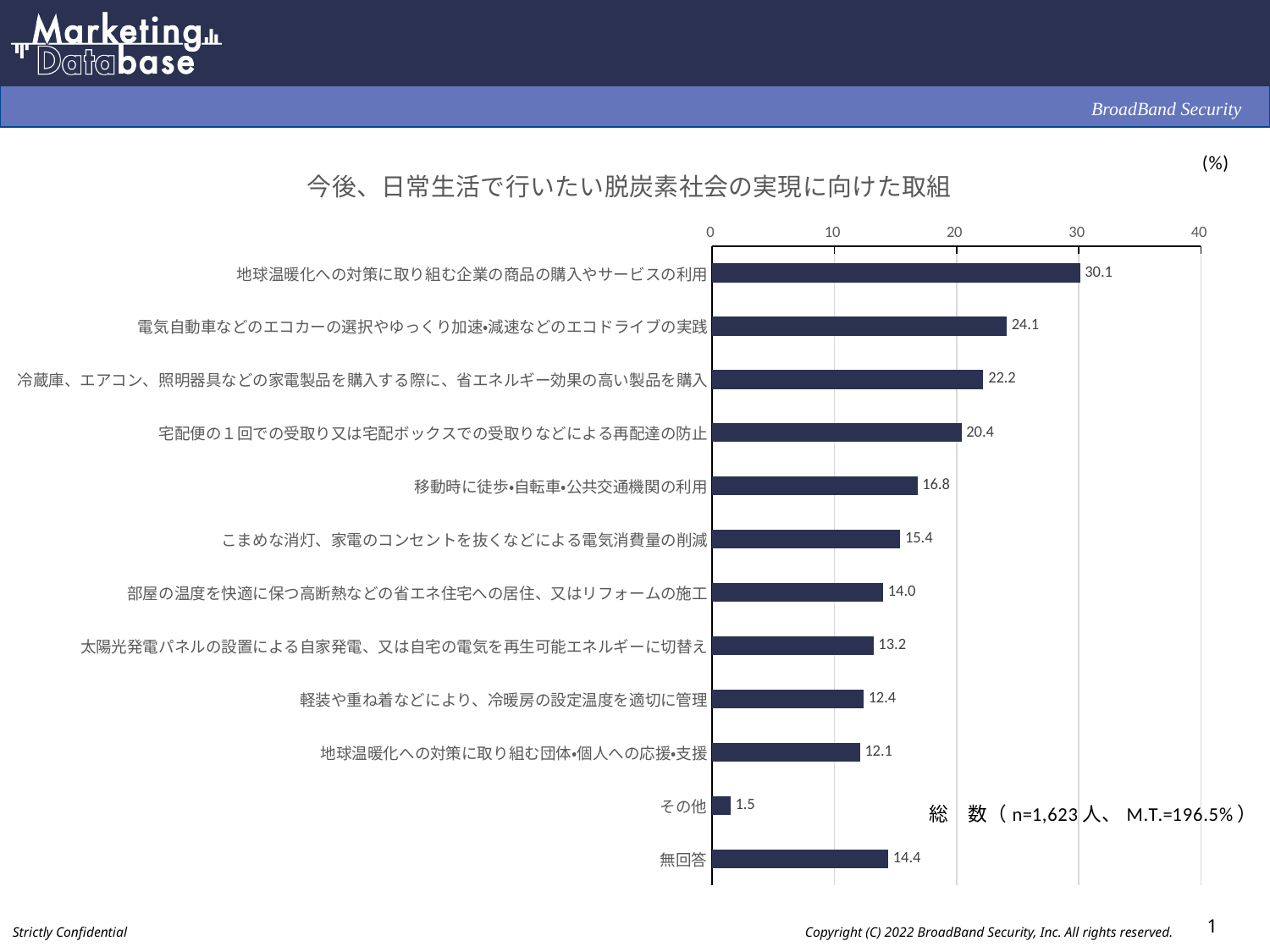
What kind of chart is shown on the slide? bar chart What is the value for 地球温暖化への対策に取り組む企業の商品の購入やサービスの利用? 30.1 Is the value for こまめな消灯、家電のコンセントを抜くなどによる電気消費量の削減 greater or less than 20? less Which is larger: the value for 軽装や重ね着などにより、冷暖房の設定温度を適切に管理 or the value for 太陽光発電パネルの設置による自家発電、又は自宅の電気を再生可能エネルギーに切替え? 太陽光発電パネルの設置による自家発電、又は自宅の電気を再生可能エネルギーに切替え What is the difference between the values for 電気自動車などのエコカーの選択やゆっくり加速•減速などのエコドライブの実践 and 宅配便の１回での受取り又は宅配ボックスでの受取りなどによる再配達の防止? 3.7 What is the title of the chart? 今後、日常生活で行いたい脱炭素社会の実現に向けた取組 Which category has the lowest value? その他 How many categories are shown in the chart? 12 What is the value for 移動時に徒歩•自転車•公共交通機関の利用? 16.8 Which category has the highest value? 地球温暖化への対策に取り組む企業の商品の購入やサービスの利用 What is the value for 無回答? 14.4 What is the sample size (n) shown on the chart? n=1,623人